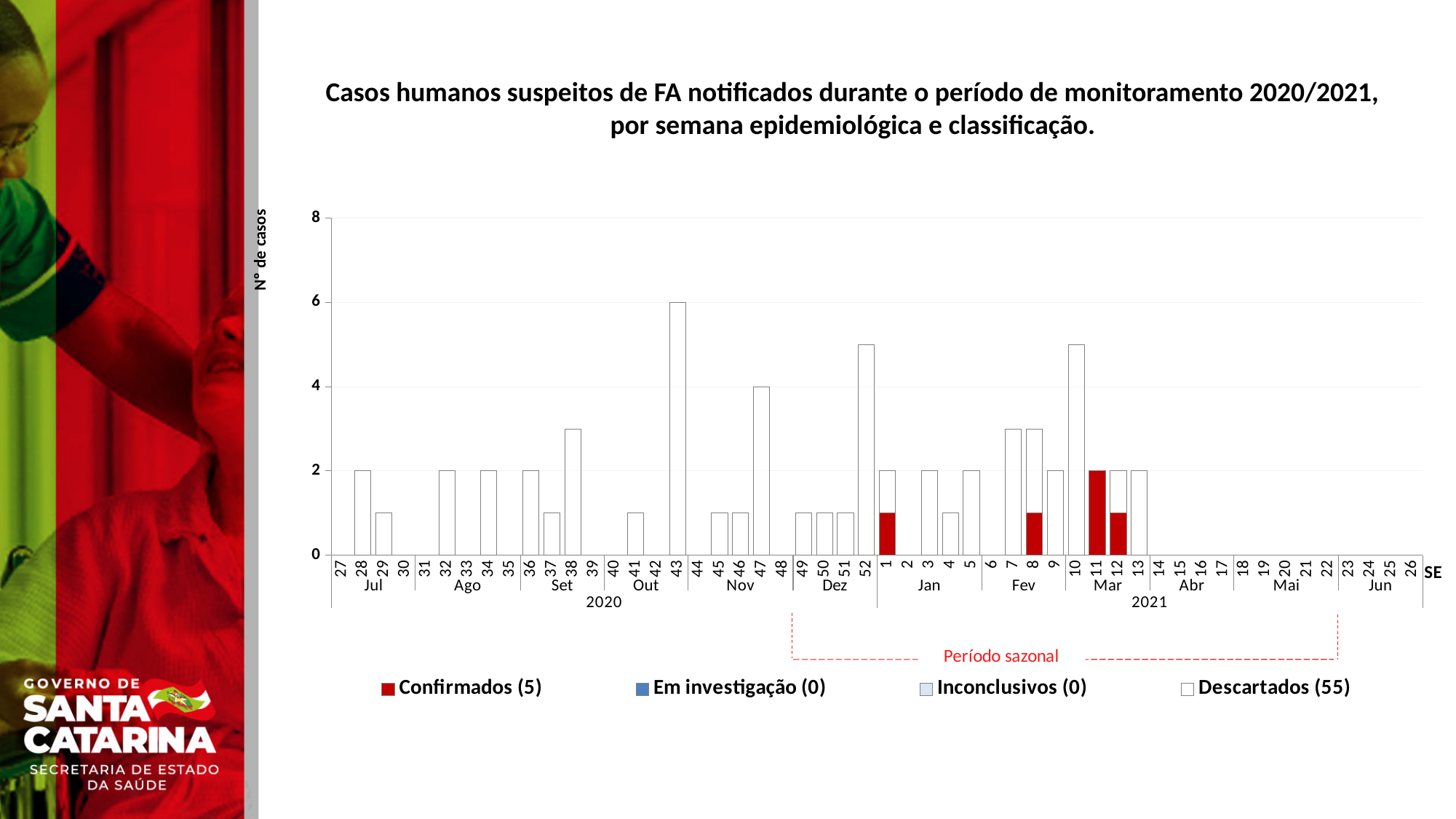
What is the number of cases in epidemiological week 28? 2 What is the difference between the number of cases in week 43 and week 28? 4 Which epidemiological week has the highest number of cases? 43 Is the number of cases in epidemiological week 52 greater or less than 4? greater What is the number of Confirmados cases in epidemiological week 11 of 2021? 2 Which has more cases, epidemiological week 43 or week 52? week 43 According to the legend, how many cases are Descartados in total? 55 What kind of chart is shown on the slide? bar chart Is the number of cases in epidemiological week 29 greater or less than 2? less What is the number of cases in epidemiological week 47? 4 What is the number of cases in epidemiological week 43? 6 How many series does the legend list? 4